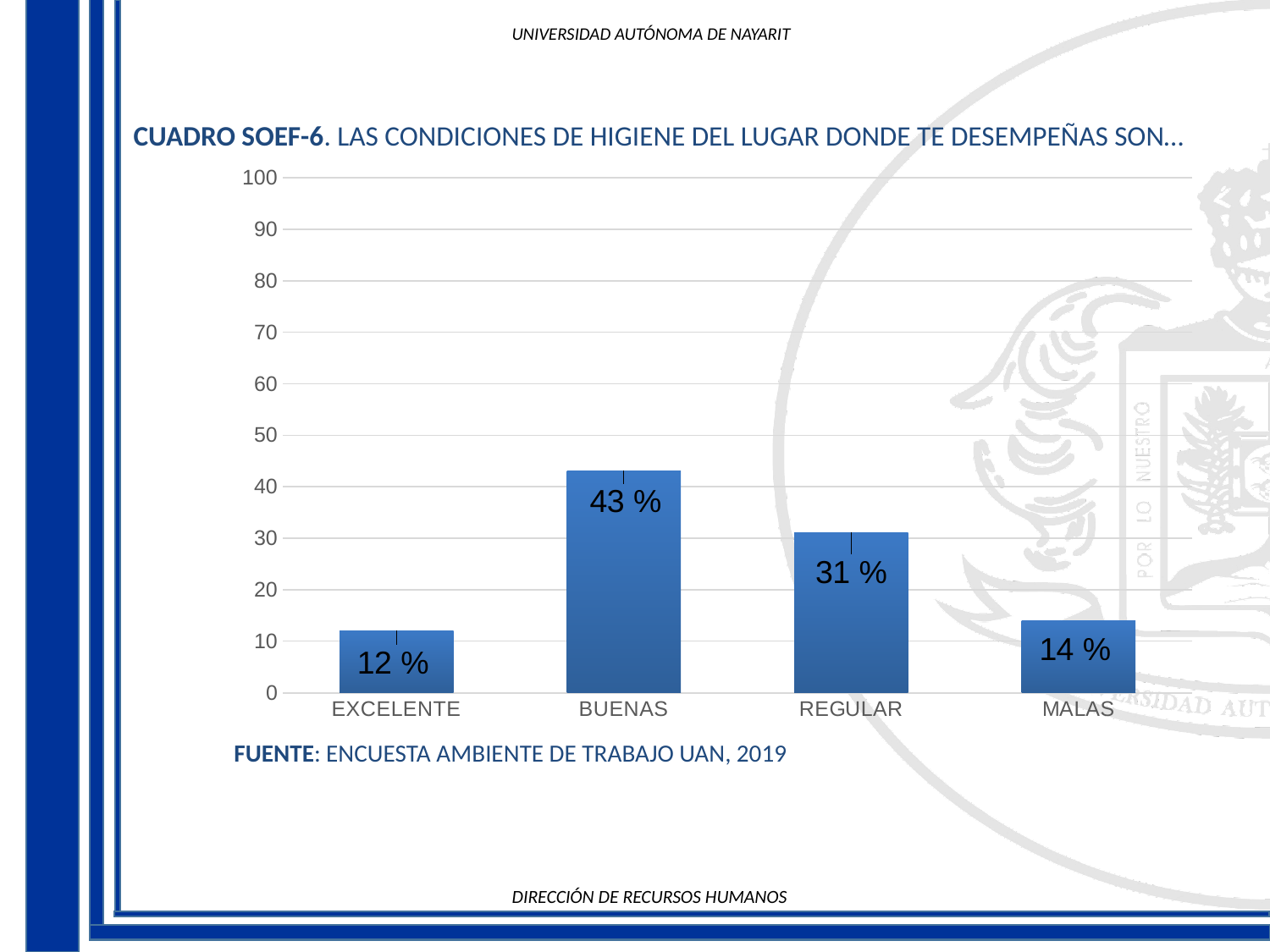
What is the difference between the values for BUENAS and REGULAR? 12 % What is the value for MALAS? 14 % How many categories are shown on the x axis? 4 What is the value for EXCELENTE? 12 % Which category has the lowest value? EXCELENTE Which category has the highest value? BUENAS What is the value for REGULAR? 31 % What is the source cited below the chart? ENCUESTA AMBIENTE DE TRABAJO UAN, 2019 What kind of chart is shown on the slide? bar chart What is the value for BUENAS? 43 % Which is larger, the value for MALAS or the value for EXCELENTE? MALAS Is the value for REGULAR greater or less than 40? less